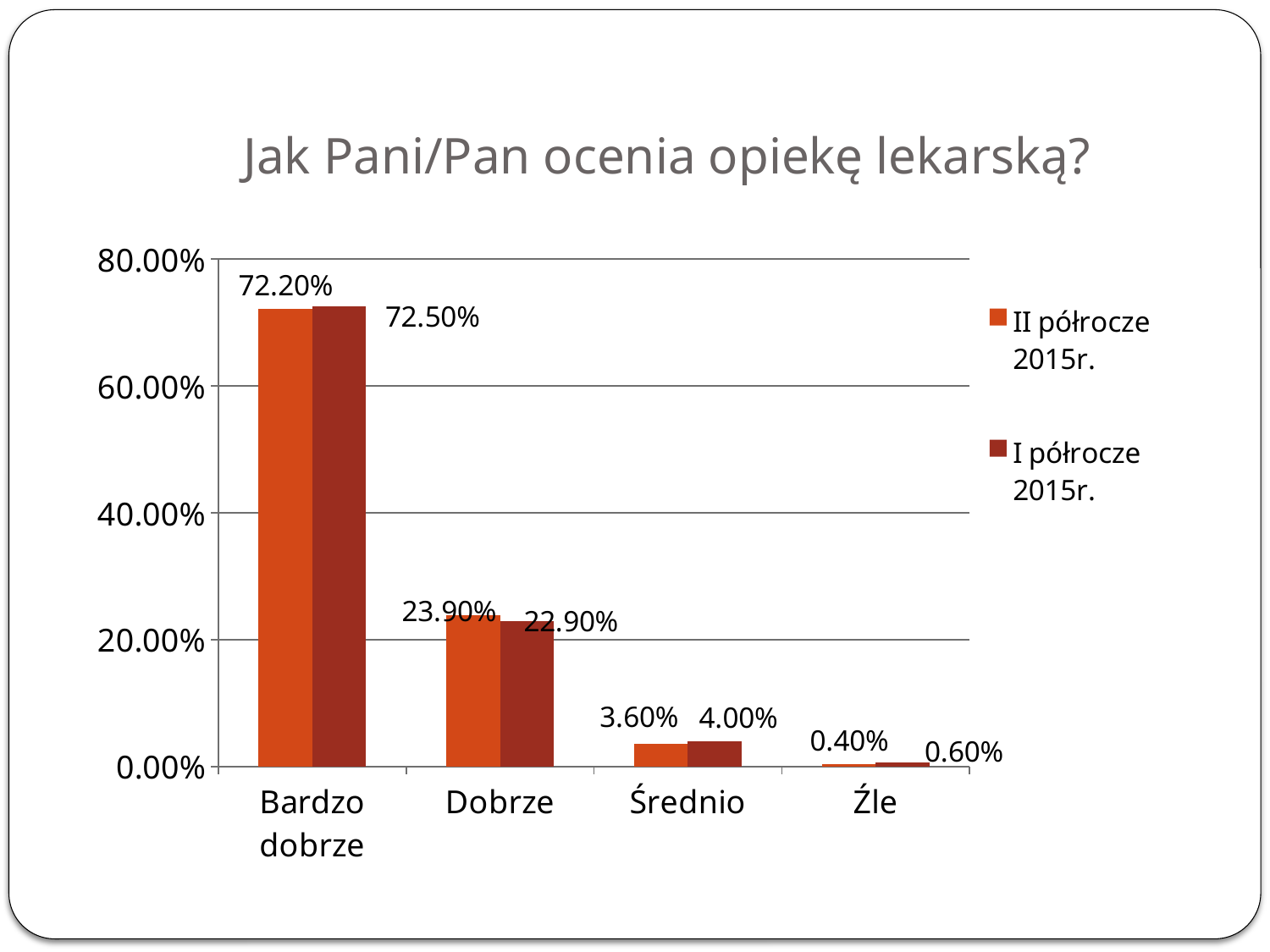
What is the value for "Bardzo dobrze" in the "II półrocze 2015r." series? 72.20% How many series does the legend list? 2 What is the difference between the "II półrocze 2015r." and "I półrocze 2015r." values for "Dobrze"? 1.00% How many categories are shown on the x axis? 4 Which category has the lowest value in the "II półrocze 2015r." series? Źle What is the value for "Dobrze" in the "I półrocze 2015r." series? 22.90% What is the value for "Źle" in the "I półrocze 2015r." series? 0.60% What is the value for "Średnio" in the "II półrocze 2015r." series? 3.60% What kind of chart is shown on the slide? Bar chart What is the title of the chart? Jak Pani/Pan ocenia opiekę lekarską? Which is larger for "Średnio": the "II półrocze 2015r." value or the "I półrocze 2015r." value? I półrocze 2015r. Which category has the highest value in the "I półrocze 2015r." series? Bardzo dobrze